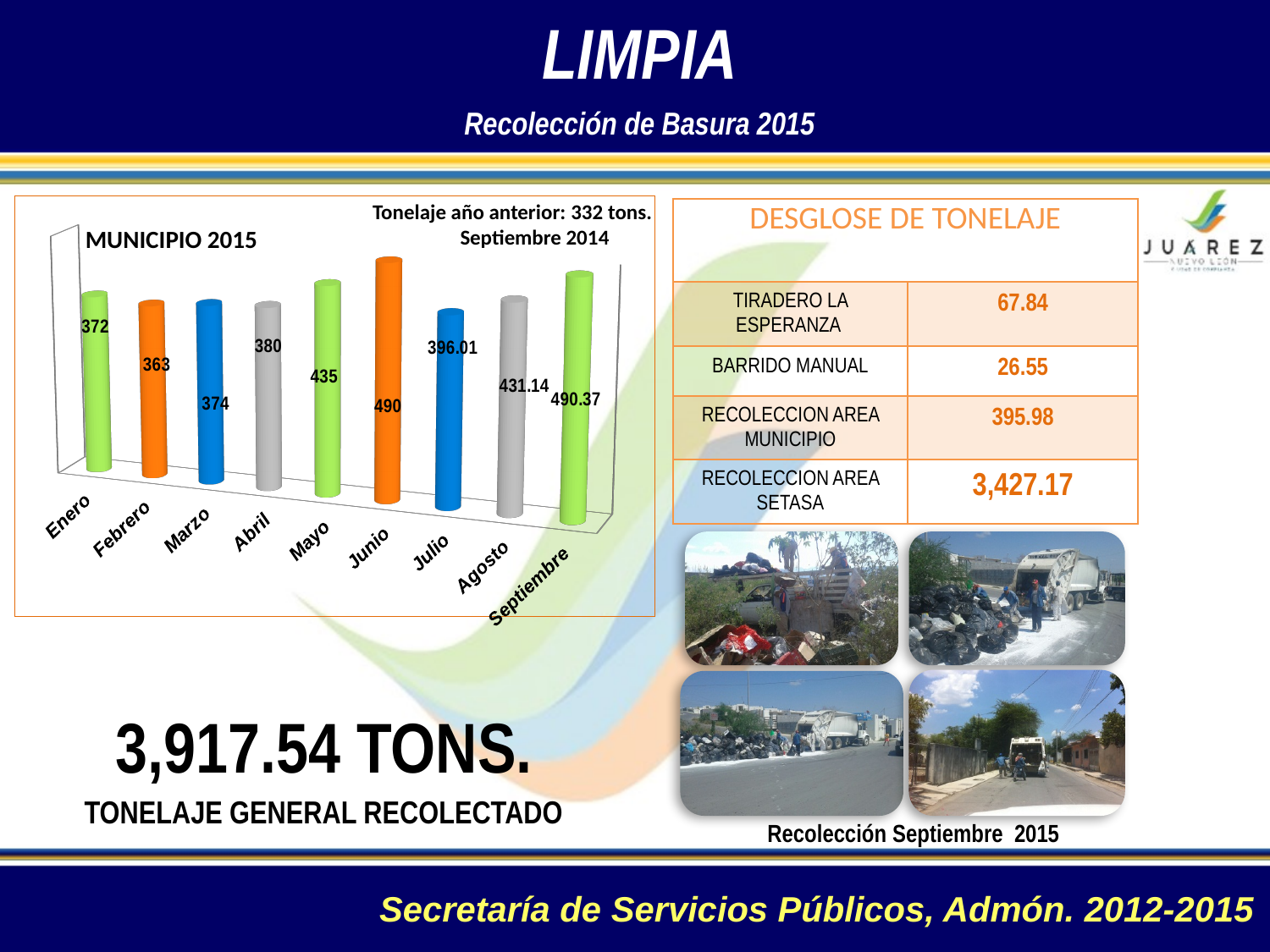
How many months are shown in the MUNICIPIO 2015 chart? 9 What is the value for Julio in the MUNICIPIO 2015 chart? 396.01 According to the note on the chart, what was the tonnage for Septiembre 2014? 332 tons Which month has the lowest value in the MUNICIPIO 2015 chart? Febrero What is the difference between the values for Junio and Febrero in the MUNICIPIO 2015 chart? 127 What is the value for Enero in the MUNICIPIO 2015 chart? 372 What kind of chart is the MUNICIPIO 2015 chart? bar chart What is the value for Septiembre in the MUNICIPIO 2015 chart? 490.37 Which is larger in the MUNICIPIO 2015 chart, the value for Mayo or the value for Abril? Mayo What is the value for Agosto in the MUNICIPIO 2015 chart? 431.14 What is the value for Junio in the MUNICIPIO 2015 chart? 490 What is the difference between the values for Septiembre and Enero in the MUNICIPIO 2015 chart? 118.37